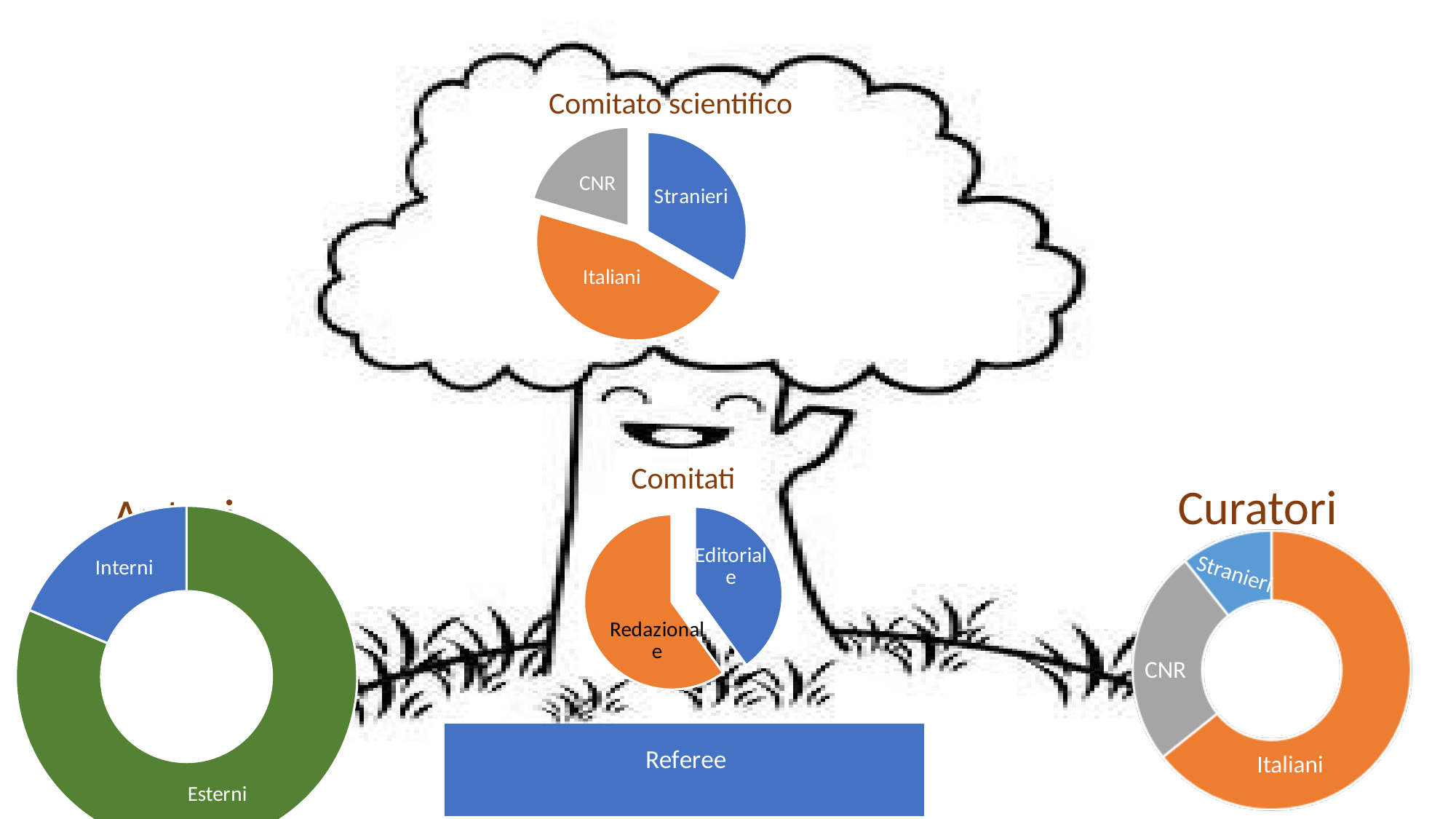
In the "Comitati" chart, which slice is larger, Editoriale or Redazionale? Redazionale What kind of chart is the "Curatori" chart? Doughnut chart How many slices does the "Comitato scientifico" pie chart have? 3 In the "Curatori" chart, which category has the smallest share? Stranieri What kind of chart is the "Comitato scientifico" chart? Pie chart In the "Comitato scientifico" chart, which slice is larger, Stranieri or CNR? Stranieri In the "Comitato scientifico" chart, which category has the largest slice? Italiani In the "Curatori" chart, which category has the largest share? Italiani In the doughnut chart at the bottom left of the slide, which segment is larger, Interni or Esterni? Esterni In the "Comitato scientifico" chart, which category has the smallest slice? CNR How many slices does the "Comitati" pie chart have? 2 What colour is the Esterni segment in the doughnut chart at the bottom left of the slide? Green